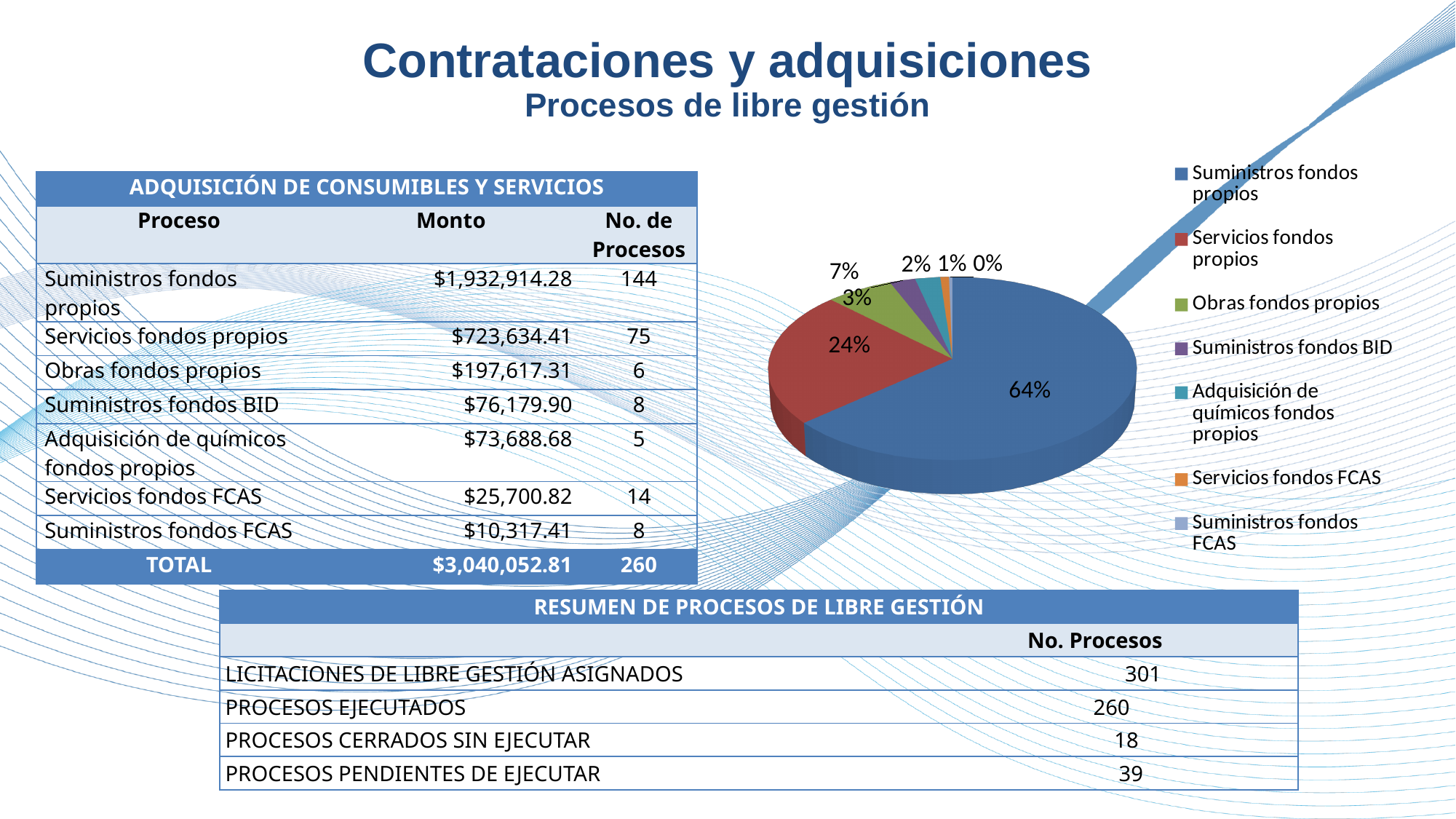
How many categories does the pie chart's legend list? 7 In the pie chart, what share does Servicios fondos propios have? 24% In the pie chart, what share does Suministros fondos propios have? 64% Which category has the largest slice in the pie chart? Suministros fondos propios In the pie chart, which slice is larger: Servicios fondos propios or Obras fondos propios? Servicios fondos propios In the pie chart, what share does Obras fondos propios have? 7% What kind of chart is shown on the slide? pie chart What colour is the Obras fondos propios slice in the pie chart? green Which category has the smallest slice in the pie chart? Suministros fondos FCAS In the pie chart, what is the difference in percentage points between the Suministros fondos propios slice and the Servicios fondos propios slice? 40 percentage points